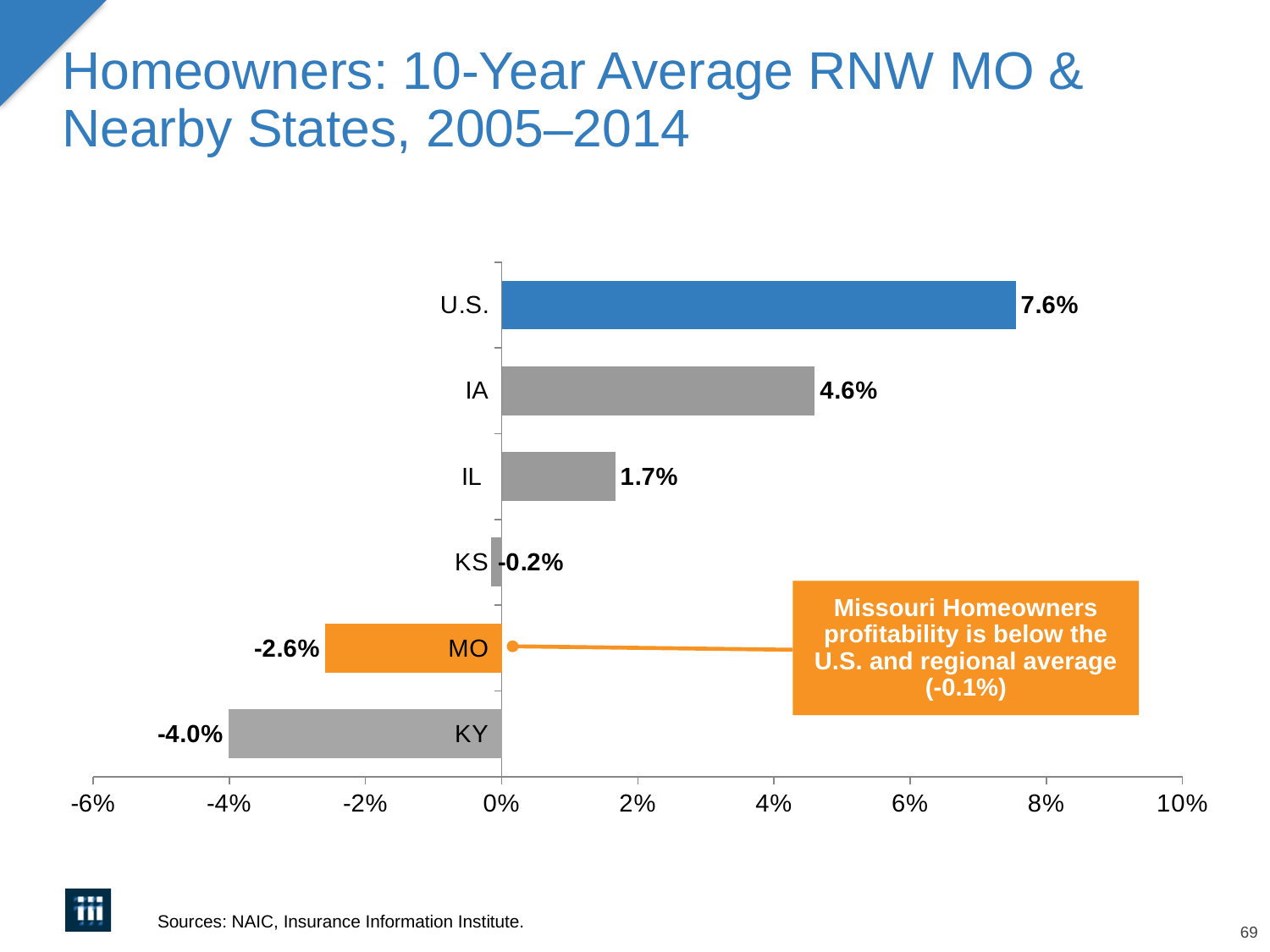
Which bar is coloured orange in the chart? MO What is the value shown for IA? 4.6% What is the difference between the IL value and the MO value? 4.3% How many categories are plotted in the chart? 6 What is the value shown for MO? -2.6% What kind of chart is shown on the slide? Bar chart Which category has the highest value in the chart? U.S. Which category has the lowest value in the chart? KY What is the difference between the U.S. value and the IA value? 3.0% What is the 10-year average RNW for the U.S. in the chart? 7.6% What is the value shown for KY? -4.0% Which has a larger value, IL or KS? IL